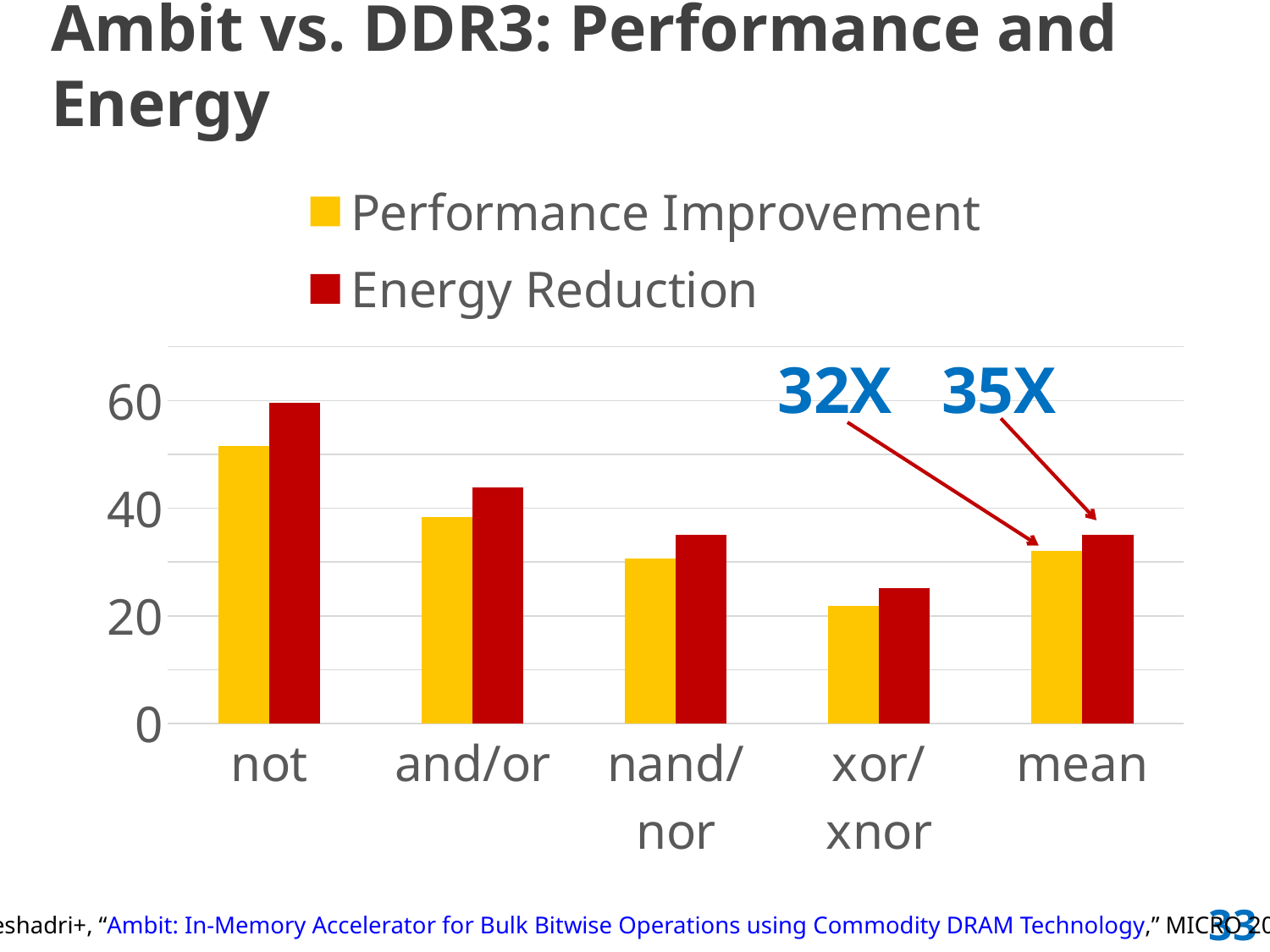
What kind of chart is shown on the slide? bar chart For the not category, which is larger: Performance Improvement or Energy Reduction? Energy Reduction Is the Energy Reduction value for not greater or less than 40? greater How many categories are shown on the x axis? 5 Which category has the highest Performance Improvement? not What is the difference between the Energy Reduction and Performance Improvement values for the mean category? 3X What is the Energy Reduction value for the mean category? 35X How many series does the legend list? 2 Do the Performance Improvement values rise or fall from not to xor/xnor? fall What is the Performance Improvement value for the mean category? 32X Is the Performance Improvement value for xor/xnor greater or less than 40? less Which category has the lowest Energy Reduction? xor/xnor